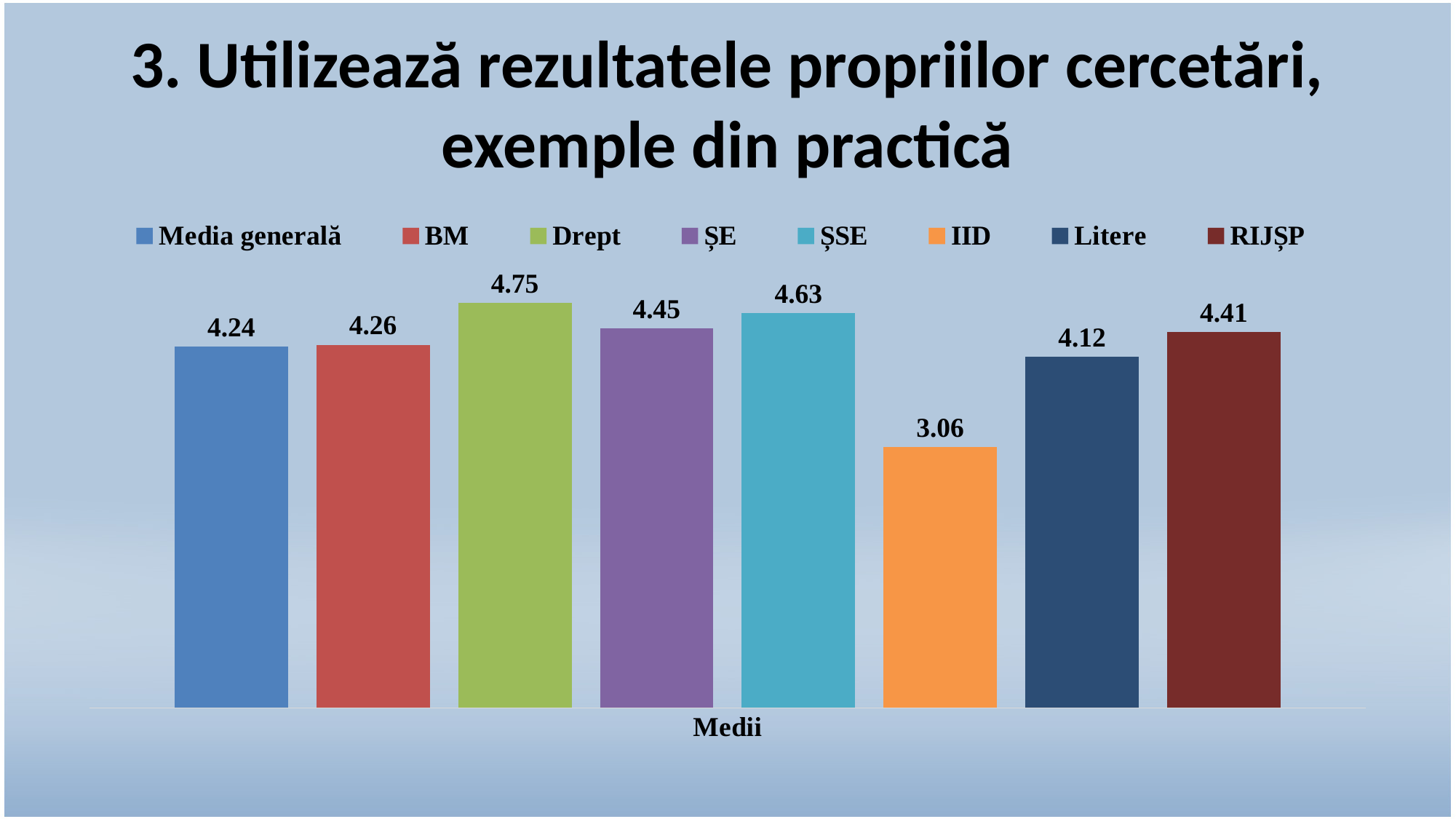
What is the value for Media generală? 4.24 Which series has the highest value? Drept How many series does the legend list? 8 Which series has the lowest value? IID What is the difference between the values for ȘSE and Litere? 0.51 What is the label shown on the x axis of the chart? Medii What kind of chart is shown on the slide? Bar chart What is the value for IID? 3.06 What is the value for Drept? 4.75 What is the value for RIJȘP? 4.41 Which is larger, the value for ȘE or the value for RIJȘP? ȘE What is the difference between the values for Drept and IID? 1.69